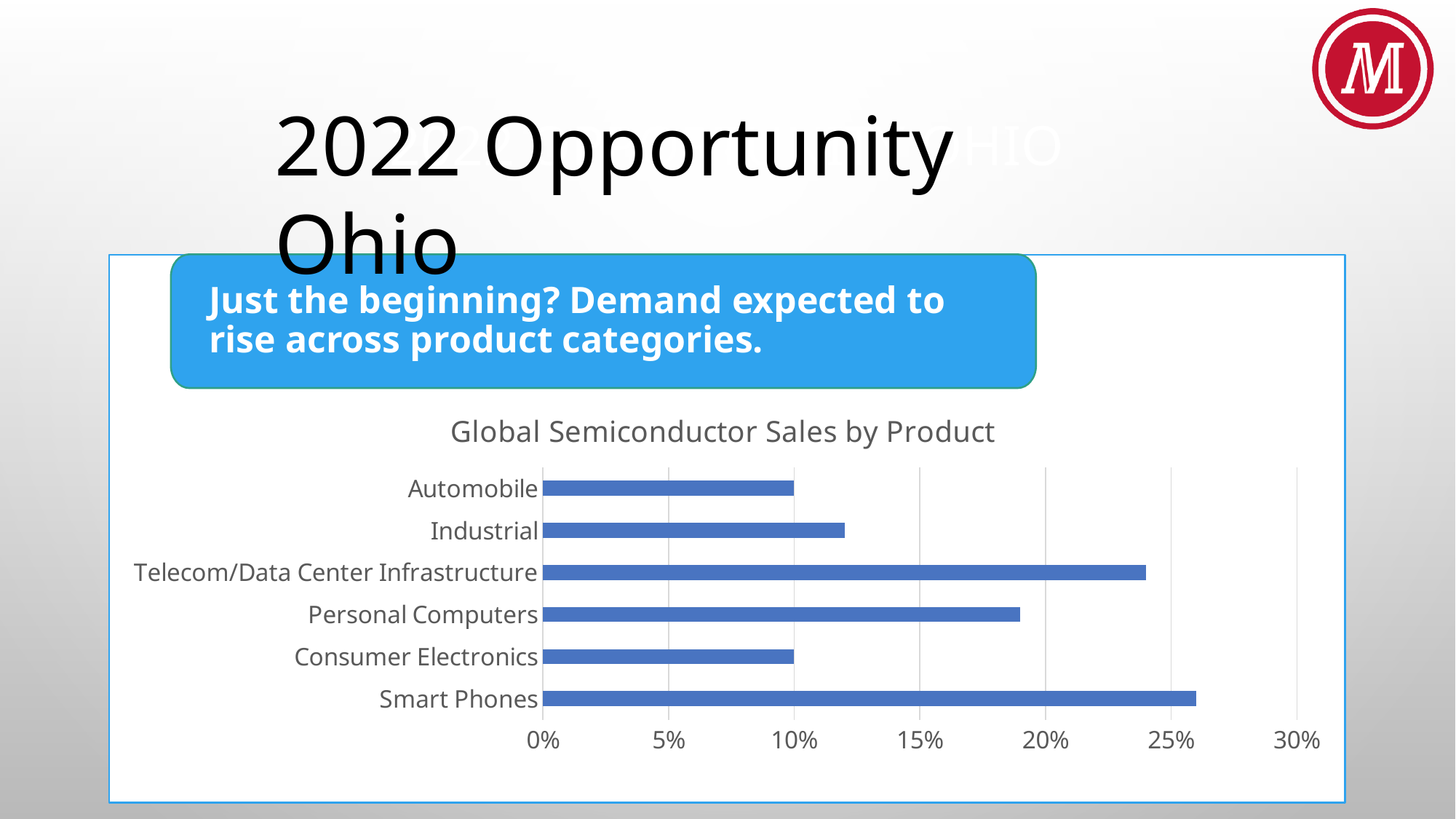
How many product categories are shown in the chart? 6 Is the value for Smart Phones greater or less than 25%? greater What is the title of the chart? Global Semiconductor Sales by Product Which is larger, the value for Industrial or the value for Automobile? Industrial What is the value for Consumer Electronics? 10% Is the value for Industrial greater or less than 10%? greater Which is larger, the value for Telecom/Data Center Infrastructure or the value for Personal Computers? Telecom/Data Center Infrastructure Is the value for Personal Computers greater or less than 20%? less Which product category has the highest value in the chart? Smart Phones What type of chart is shown on the slide? bar chart What is the value for Automobile? 10%